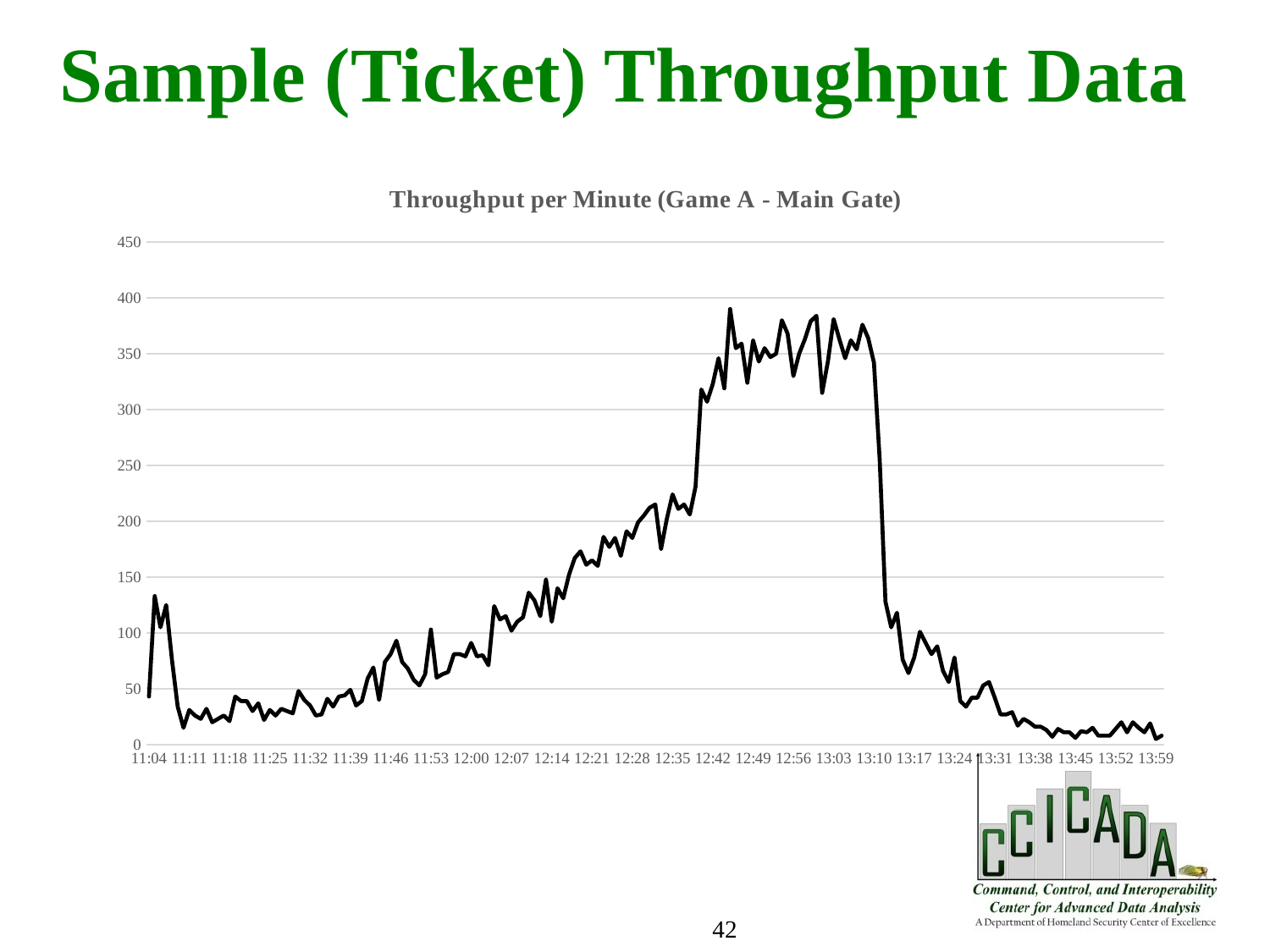
What is the title of the chart? Throughput per Minute (Game A - Main Gate) What kind of chart is shown on the slide? line chart Between 12:00 and 12:42, does the throughput generally rise or fall? rise What is the highest value labelled on the y axis? 450 Between 13:10 and 13:31, does the throughput rise or fall? fall Which is larger, the value at 11:11 or the value at 12:49? 12:49 Is the value at 11:11 greater or less than 50? less Does the line ever rise above 400? no Is the value at 12:35 greater or less than 150? greater